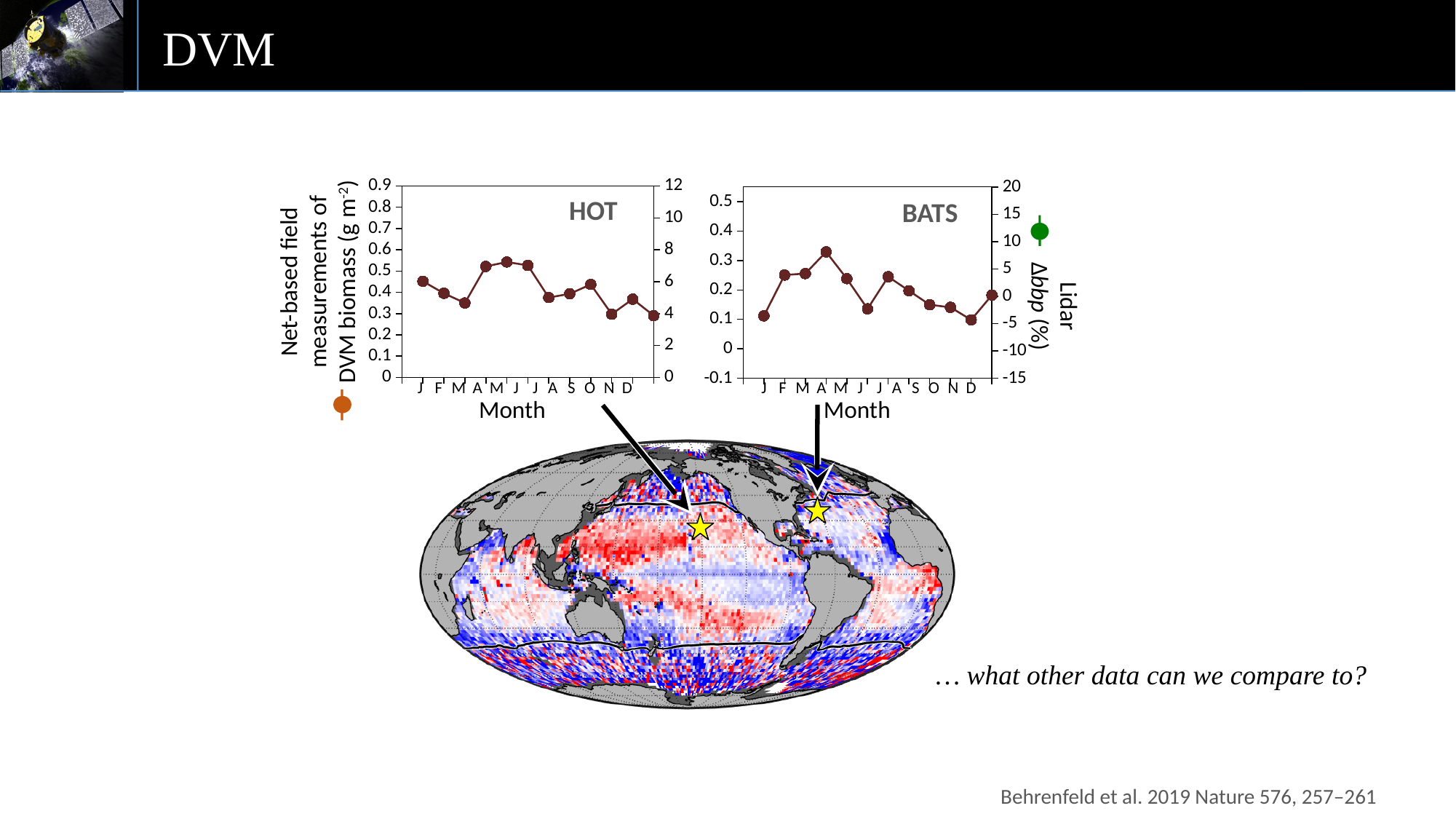
In the BATS chart, is the value for April greater or less than 0.3? greater In the BATS chart, do the values rise or fall from April to June? fall In the HOT chart, is the value for May greater or less than 0.5? greater In the HOT chart, is the value for March greater or less than 0.4? less How many months are plotted along the x axis of the BATS chart? 12 What kind of chart is the HOT chart? line chart In the HOT chart, which is larger, the value for May or the value for March? May In the HOT chart, do the values rise or fall from January to March? fall In the BATS chart, which month has the highest value? April What is the label of the right-hand y axis on the BATS chart? Lidar Δbbp (%)